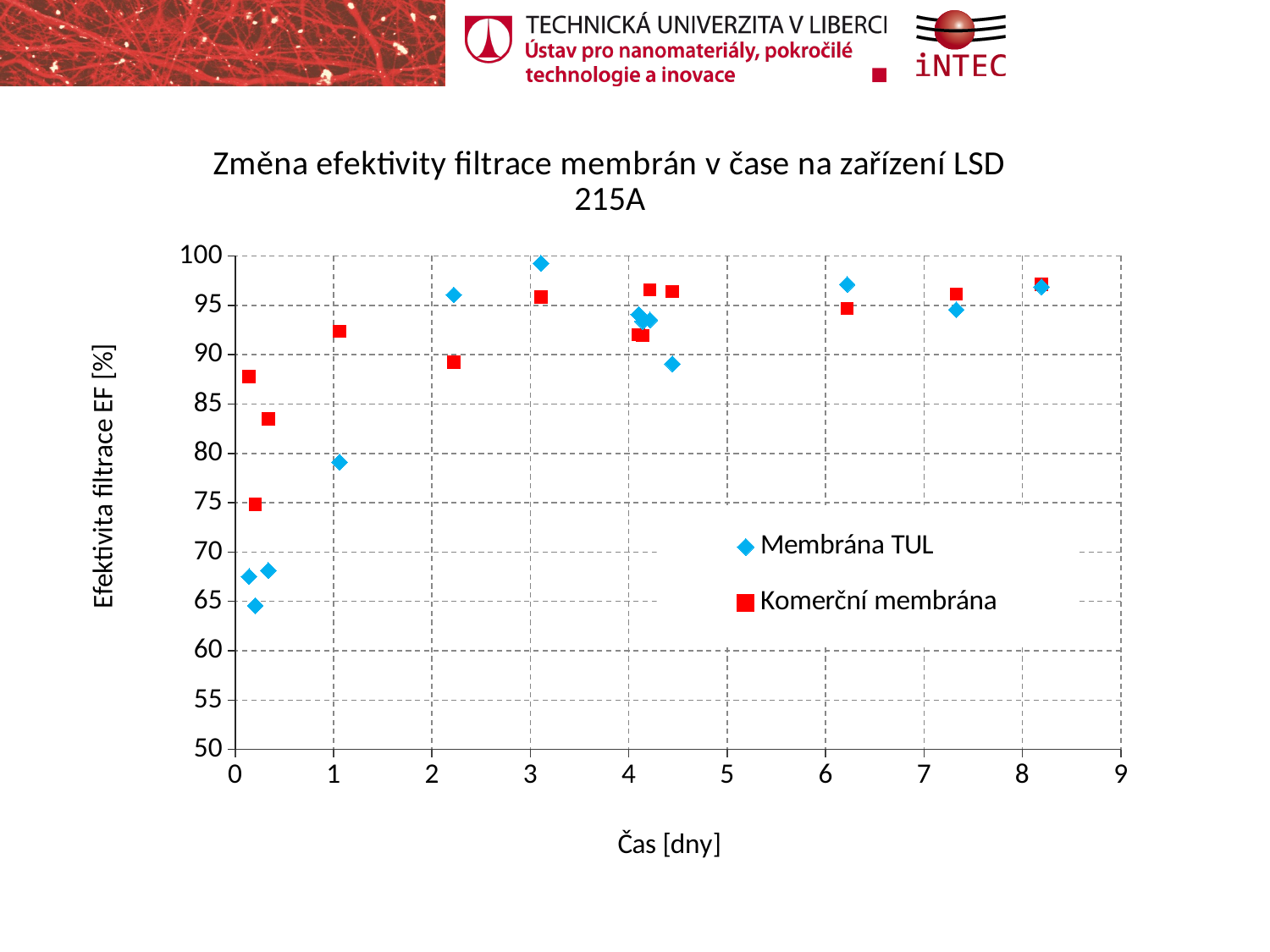
What kind of chart is shown on the slide? scatter chart Is the value for Komerční membrána at about day 1 greater or less than 90? greater Do the Membrána TUL values generally rise or fall as time increases? rise What are the two series named in the legend? Membrána TUL and Komerční membrána Is the value for Komerční membrána at about day 2 greater or less than 85? greater Which series contains the lowest point on the chart? Membrána TUL Is the value for Membrána TUL at about day 3 greater or less than 95? greater What is the label of the x axis? Čas [dny] How many series does the legend list? 2 At about day 3, which series has the higher filtration efficiency? Membrána TUL At about day 1, which series has the higher filtration efficiency? Komerční membrána